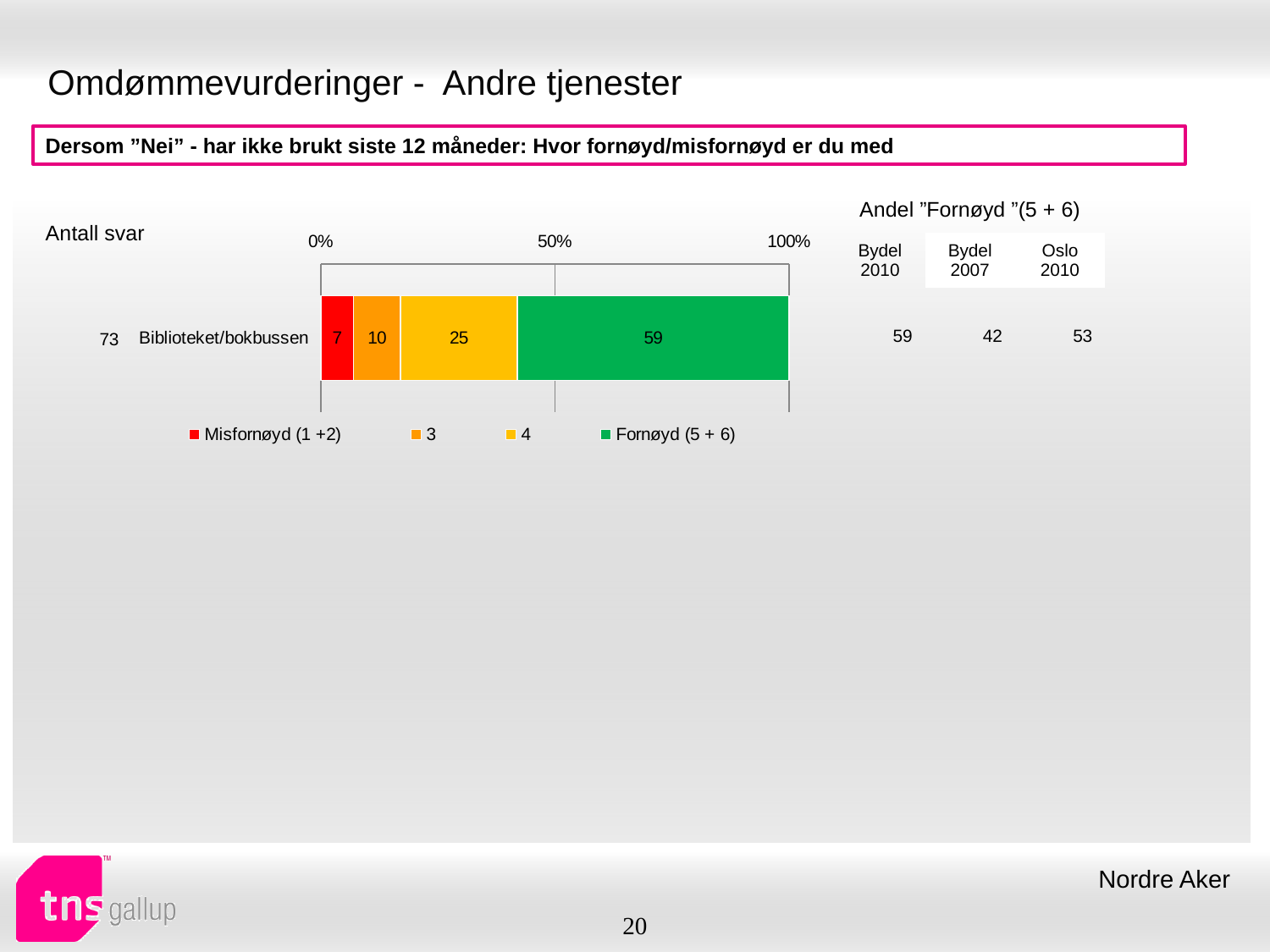
How many series does the legend list? 4 What kind of chart is shown on the slide? stacked bar chart What colour is the "Fornøyd (5 + 6)" series in the chart? green What is the value of the "3" segment for Biblioteket/bokbussen? 10 What is the value of the "Misfornøyd (1 +2)" segment for Biblioteket/bokbussen? 7 What is the difference between the "Fornøyd (5 + 6)" and "4" segments for Biblioteket/bokbussen? 34 Which segment of the Biblioteket/bokbussen bar is the smallest? Misfornøyd (1 +2) What is the value of the "4" segment for Biblioteket/bokbussen? 25 How many categories does the chart show? 1 Which segment of the Biblioteket/bokbussen bar is the largest? Fornøyd (5 + 6) Is the "Fornøyd (5 + 6)" segment for Biblioteket/bokbussen larger or smaller than the "3" segment? larger What is the value of the "Fornøyd (5 + 6)" segment for Biblioteket/bokbussen? 59